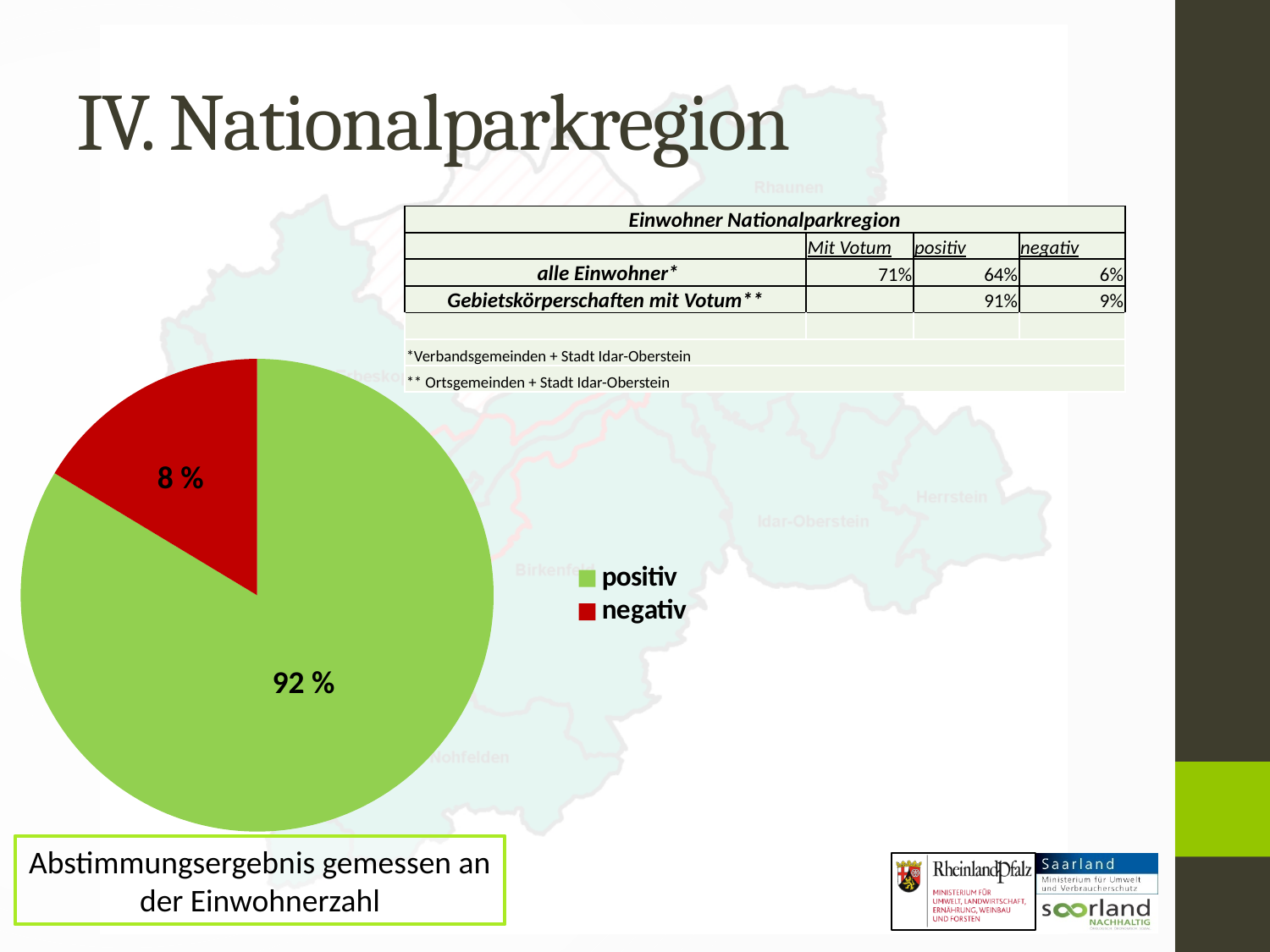
How many entries does the pie chart's legend list? 2 What kind of chart is shown on the slide? pie chart What colour is the "negativ" slice in the pie chart? red What colour is the "positiv" slice in the pie chart? green What share of the pie does the "negativ" slice represent? 8 % Which slice of the pie chart is the smallest? negativ Which is larger in the pie chart, "positiv" or "negativ"? positiv What is the difference in percentage points between the "positiv" and "negativ" slices of the pie chart? 84 Which slice of the pie chart is the largest? positiv How many slices does the pie chart have? 2 What is the value of the "negativ" slice in the pie chart? 8 % What is the value of the "positiv" slice in the pie chart? 92 %